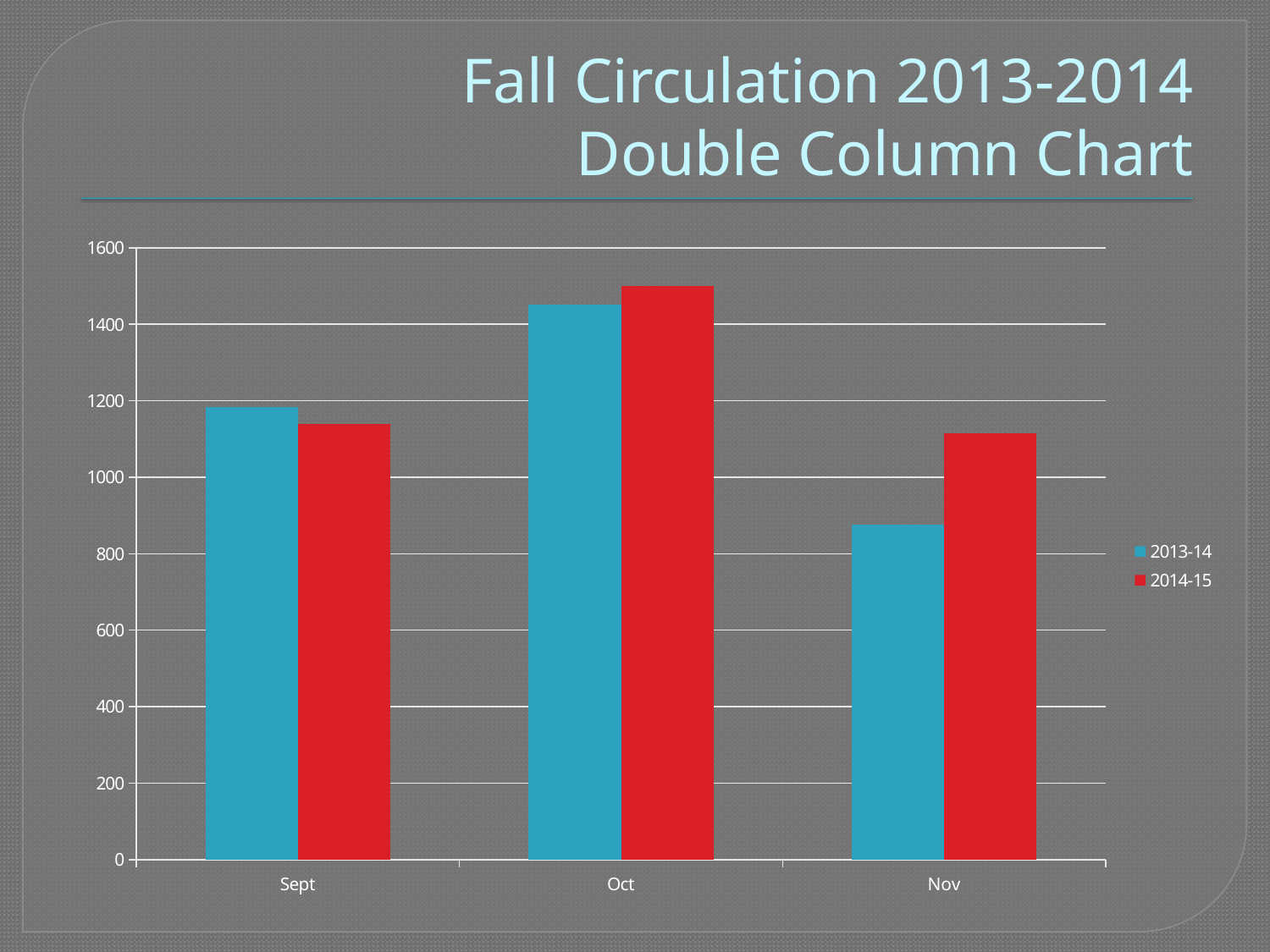
Which month has the highest value for the 2014-15 series? Oct Is the 2014-15 value for Nov greater or less than 1000? greater Which month has the highest value for the 2013-14 series? Oct How many months are shown on the x axis? 3 Is the 2014-15 value for Oct greater or less than 1400? greater Which month has the lowest value for the 2013-14 series? Nov In Nov, which series has the larger value, 2013-14 or 2014-15? 2014-15 What kind of chart is shown on the slide? bar chart Is the 2013-14 value for Nov greater or less than 1000? less Which colour represents the 2014-15 series in the legend? red In Oct, which series has the larger value, 2013-14 or 2014-15? 2014-15 How many series does the legend list? 2